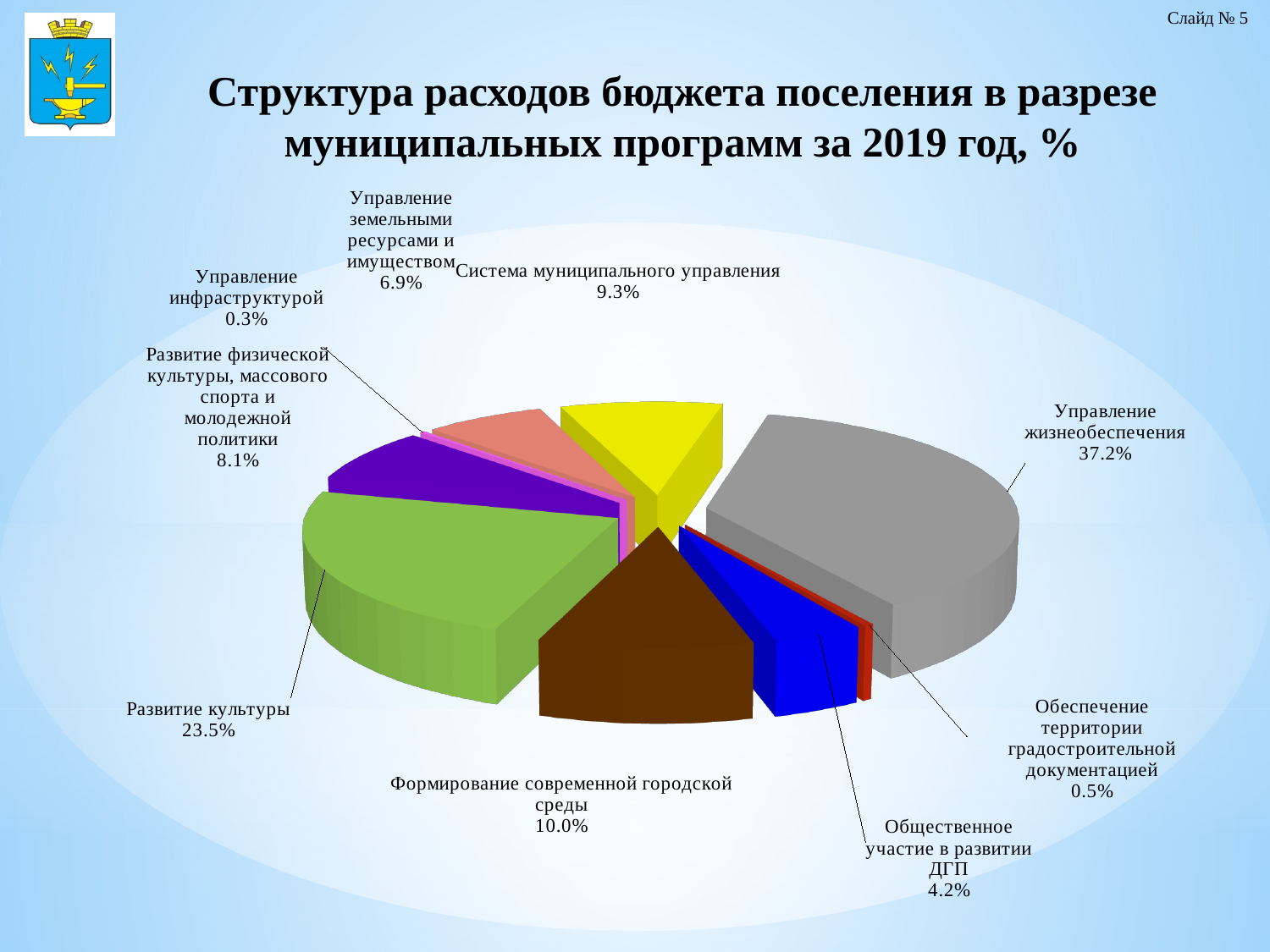
Which program has the largest share of the budget expenditures? Управление жизнеобеспечения What is the value for "Система муниципального управления"? 9.3% What is the title of the chart on the slide? Структура расходов бюджета поселения в разрезе муниципальных программ за 2019 год, % What share of expenditures goes to "Управление жизнеобеспечения"? 37.2% How many programs (slices) are shown in the pie chart? 9 What kind of chart is shown on the slide? pie chart What share is labelled for "Общественное участие в развитии ДГП"? 4.2% What is the value shown for "Развитие культуры"? 23.5% Which program has the smallest share of the budget expenditures? Управление инфраструктурой What is the difference in percentage points between "Управление жизнеобеспечения" and "Развитие культуры"? 13.7 Which is larger: the share for "Система муниципального управления" or for "Управление земельными ресурсами и имуществом"? Система муниципального управления What percentage is shown for "Формирование современной городской среды"? 10.0%